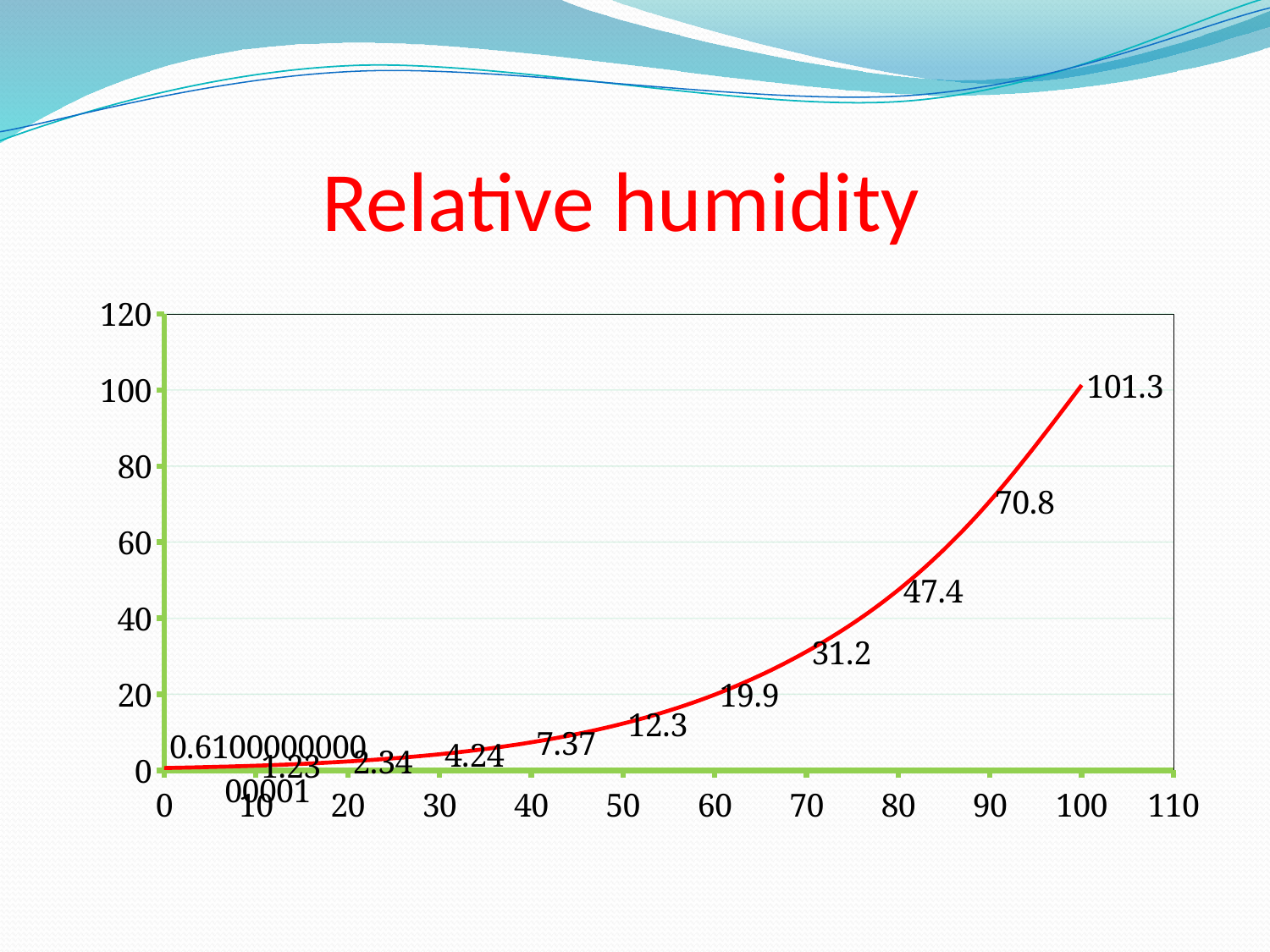
What is the value plotted at x = 40? 7.37 What is the value plotted at x = 100? 101.3 Do the plotted values rise or fall as x increases? rise What is the title of the chart? Relative humidity At which x value is the plotted value highest? 100 What is the difference between the values at x = 80 and x = 70? 16.2 What is the value plotted at x = 70? 31.2 Is the value at x = 80 greater or less than 40? greater What is the value plotted at x = 90? 70.8 What kind of chart is shown on the slide? line chart Which is larger, the value at x = 60 or the value at x = 50? x = 60 What is the difference between the values at x = 100 and x = 90? 30.5